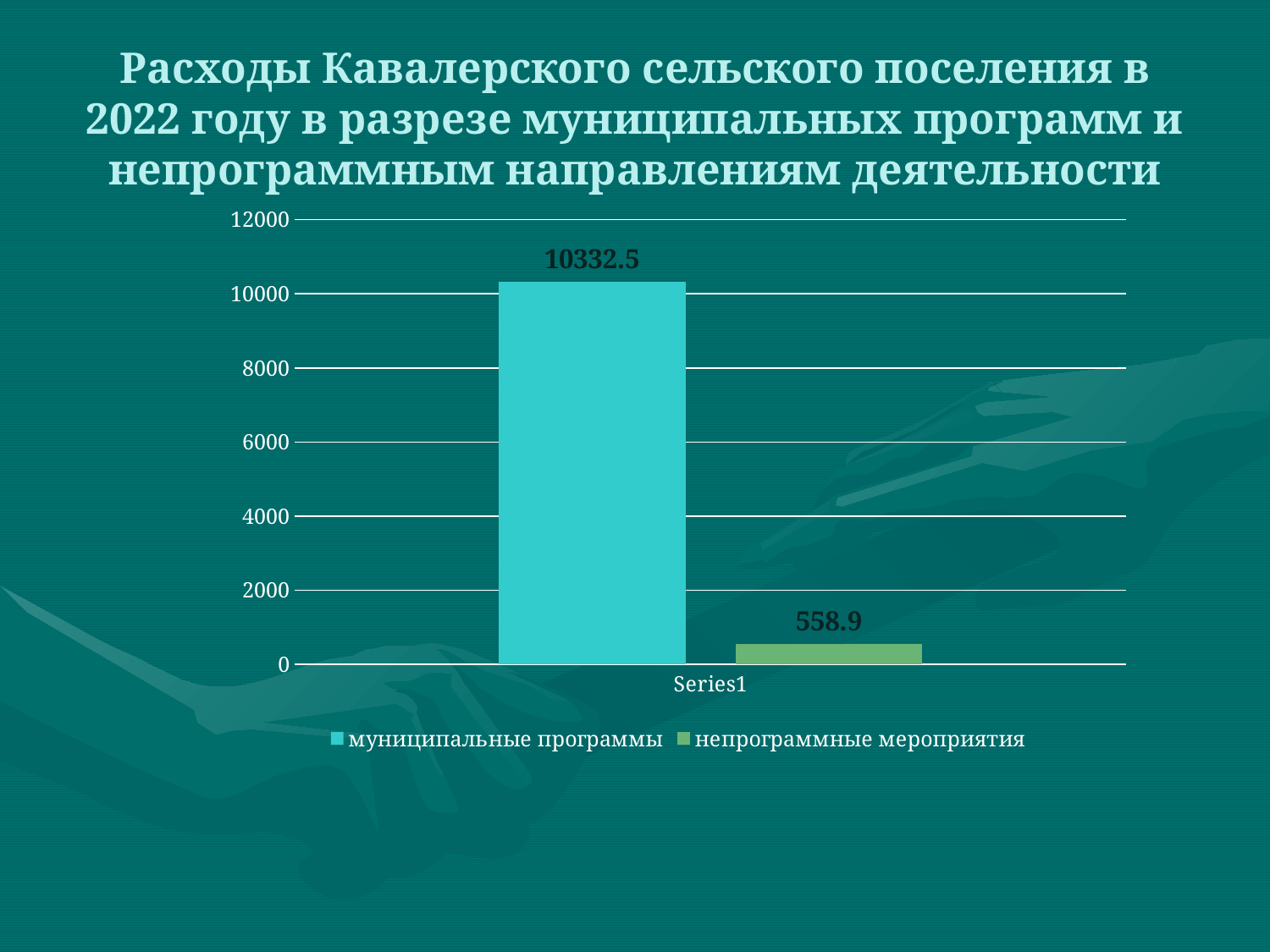
Which is larger, муниципальные программы or непрограммные мероприятия? муниципальные программы What is the difference between муниципальные программы and непрограммные мероприятия? 9773.6 What is the category label shown on the x axis? Series1 Is the value for муниципальные программы greater or less than 10000? greater Which series has the highest value? муниципальные программы What is the total of the two plotted values? 10891.4 How many series does the legend list? 2 Which series has the lowest value? непрограммные мероприятия What kind of chart is shown on the slide? bar chart What is the value for непрограммные мероприятия? 558.9 What is the value for муниципальные программы? 10332.5 Is the value for непрограммные мероприятия greater or less than 2000? less